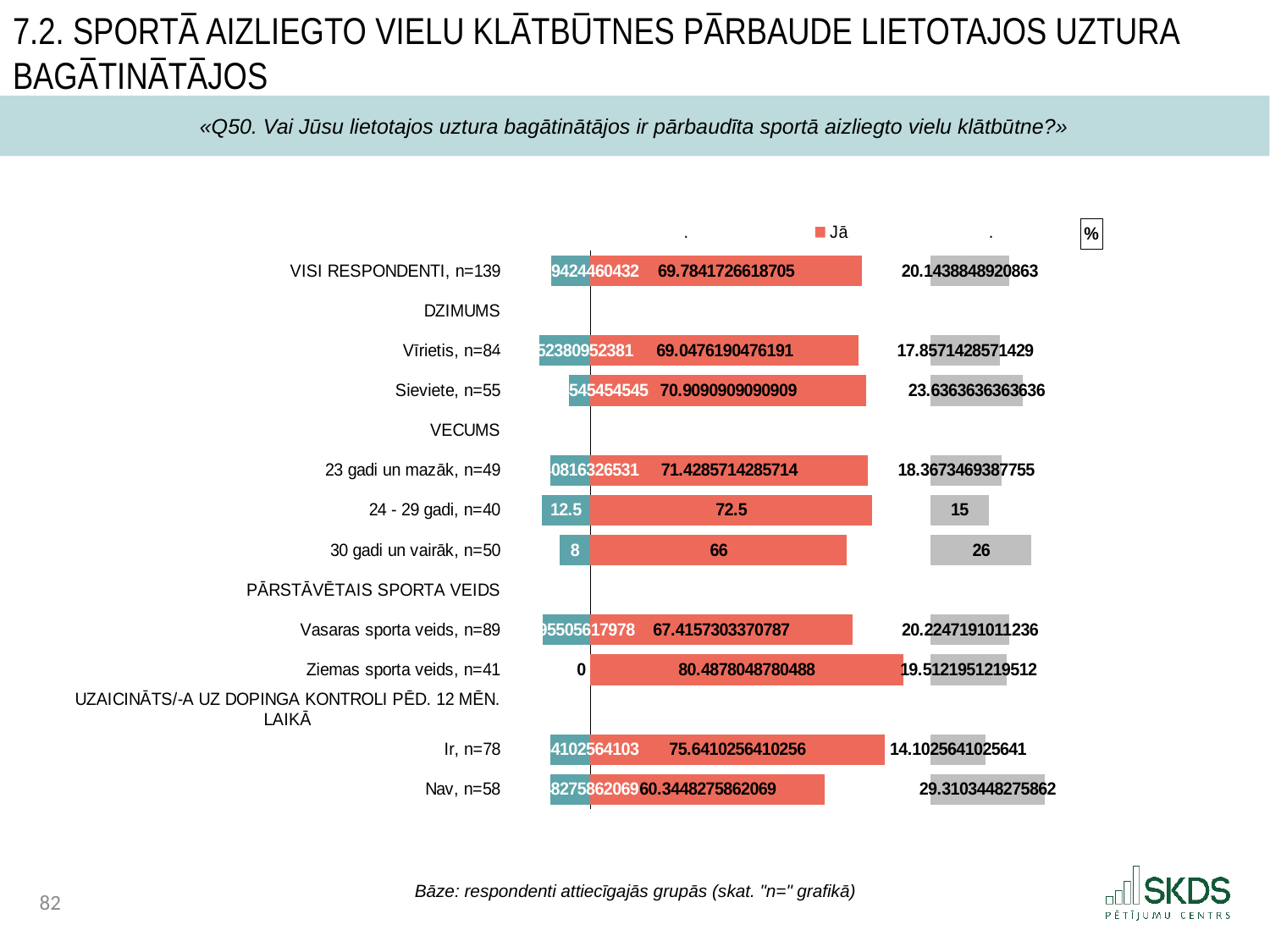
What type of chart is shown on the slide? bar chart For '24 - 29 gadi, n=40', what is the difference between the red 'Jā' value and the gray (rightmost) value? 57.5 Which has a larger red 'Jā' value: 'Ir, n=78' or 'Nav, n=58'? Ir, n=78 Which legend entry is readable in the chart legend? Jā What is the value of the red 'Jā' bar for '24 - 29 gadi, n=40'? 72.5 Which group has the lowest value in the red 'Jā' series? Nav, n=58 What is the total of the three bar segments for '30 gadi un vairāk, n=50'? 100 What is the value of the teal (leftmost) bar for 'Ziemas sporta veids, n=41'? 0 What is the value of the red 'Jā' bar for 'Ziemas sporta veids, n=41'? 80.4878048780488 Which group has the highest value in the red 'Jā' series? Ziemas sporta veids, n=41 What is the value of the gray (rightmost) bar for '30 gadi un vairāk, n=50'? 26 What is the value of the red 'Jā' bar for 'VISI RESPONDENTI, n=139'? 69.7841726618705